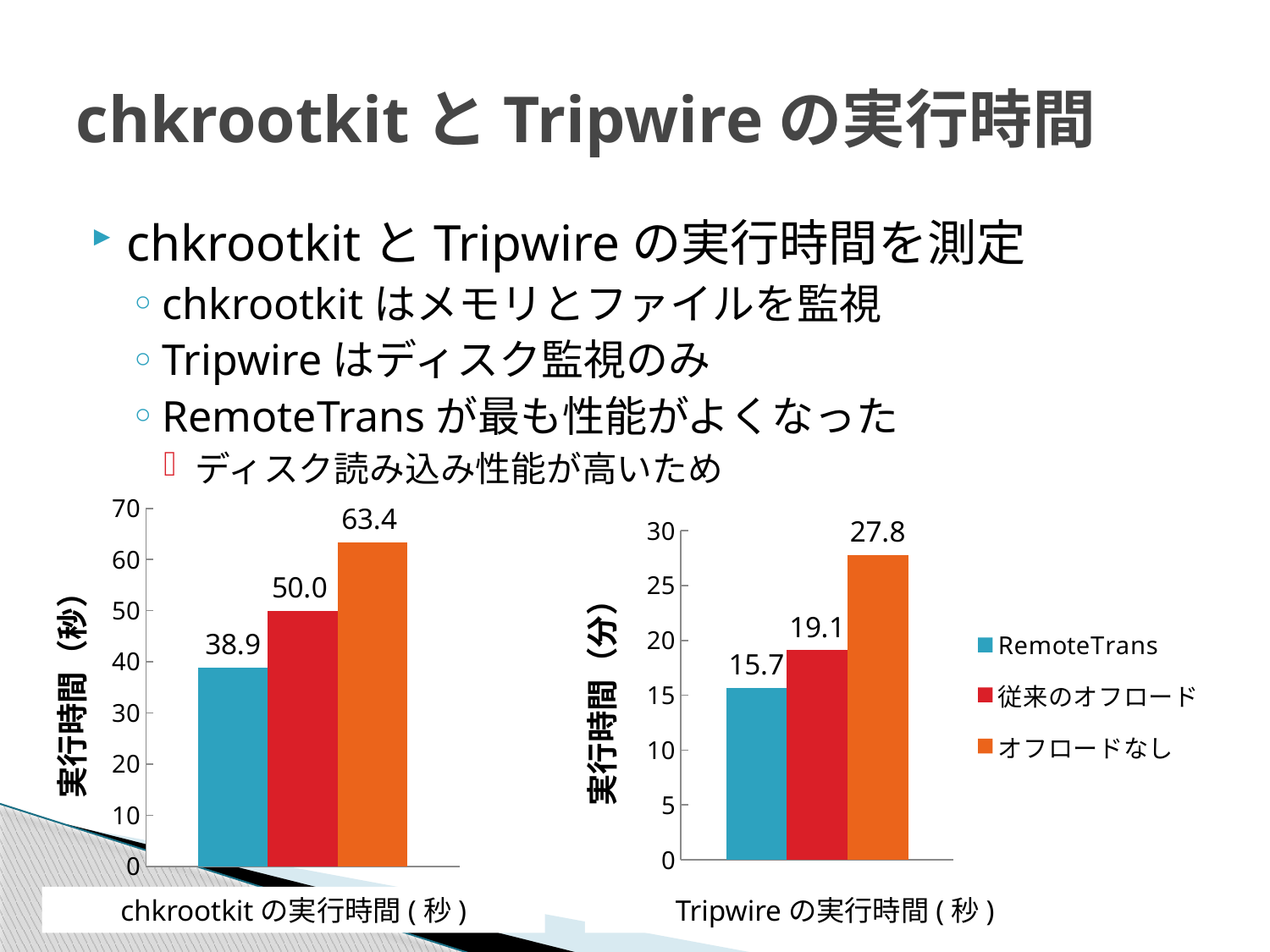
In the left chart (chkrootkit の実行時間), what is the difference between オフロードなし and RemoteTrans? 24.5 In the left chart (chkrootkit の実行時間), what is the value for RemoteTrans? 38.9 In the right chart (Tripwire の実行時間), what is the value for RemoteTrans? 15.7 In the left chart (chkrootkit の実行時間), what is the value for オフロードなし? 63.4 How many series does the legend list? 3 In the right chart (Tripwire の実行時間), which series has the lowest value? RemoteTrans In the left chart (chkrootkit の実行時間), which series has the highest value? オフロードなし What colour represents RemoteTrans in the legend? Blue In the right chart (Tripwire の実行時間), what is the value for 従来のオフロード? 19.1 What kind of chart is the left chart (chkrootkit の実行時間)? Bar chart In the left chart (chkrootkit の実行時間), which is larger, 従来のオフロード or RemoteTrans? 従来のオフロード In the right chart (Tripwire の実行時間), what is the difference between オフロードなし and 従来のオフロード? 8.7